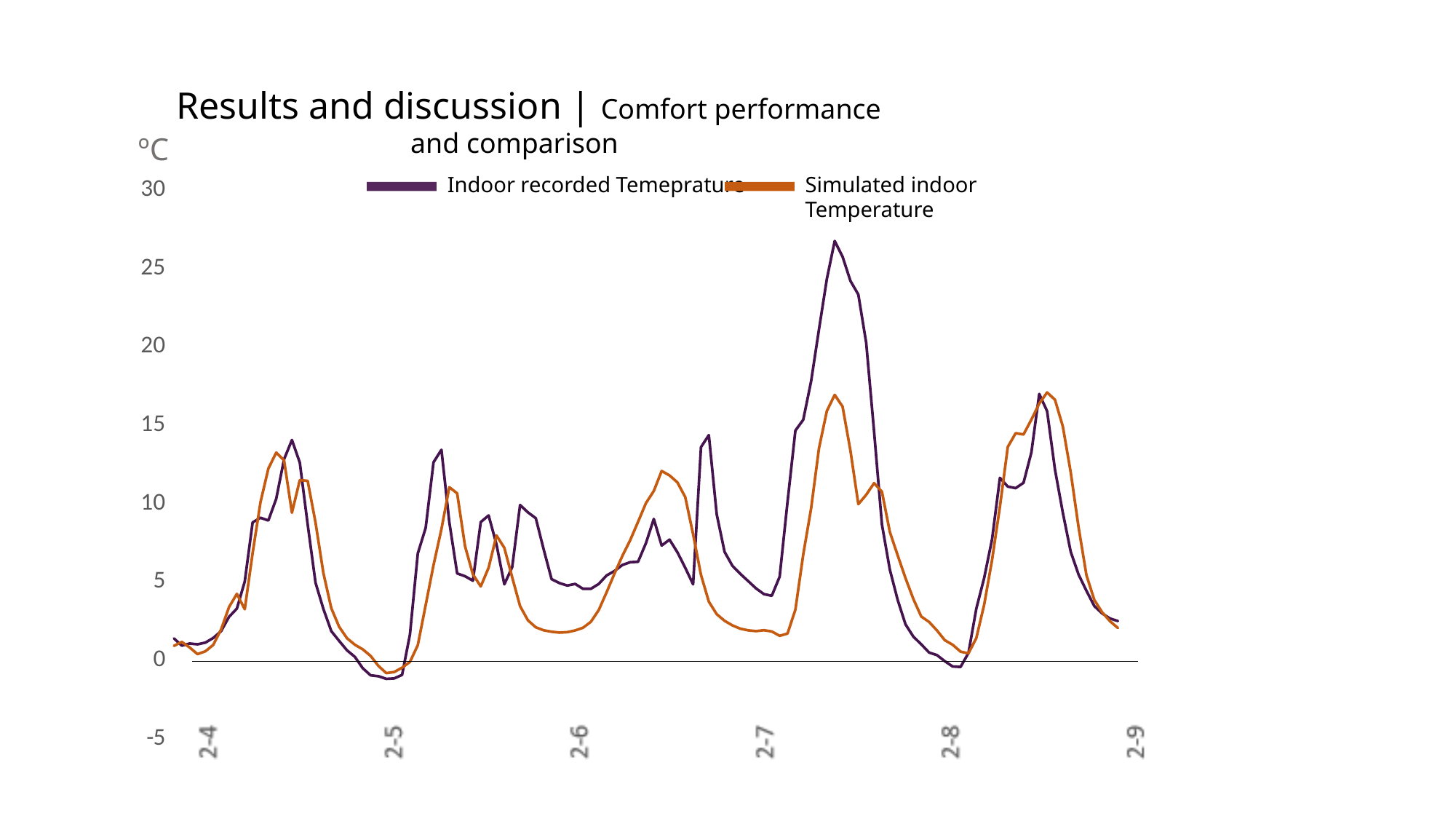
Is the highest peak of the Indoor recorded Temeprature line greater or less than 25? greater How many date labels are shown along the x axis? 6 What kind of chart is shown on the slide? line chart What are the two series named in the legend? Indoor recorded Temeprature and Simulated indoor Temperature How many series does the legend list? 2 What unit is shown at the top of the vertical axis? °C At the tallest peak between 2-7 and 2-8, which series has the larger value, Indoor recorded Temeprature or Simulated indoor Temperature? Indoor recorded Temeprature Which series reaches the highest value anywhere on the chart? Indoor recorded Temeprature Is the highest peak of the Simulated indoor Temperature line greater or less than 20? less Is the lowest value of the Indoor recorded Temeprature line, near 2-5, greater or less than 0? less